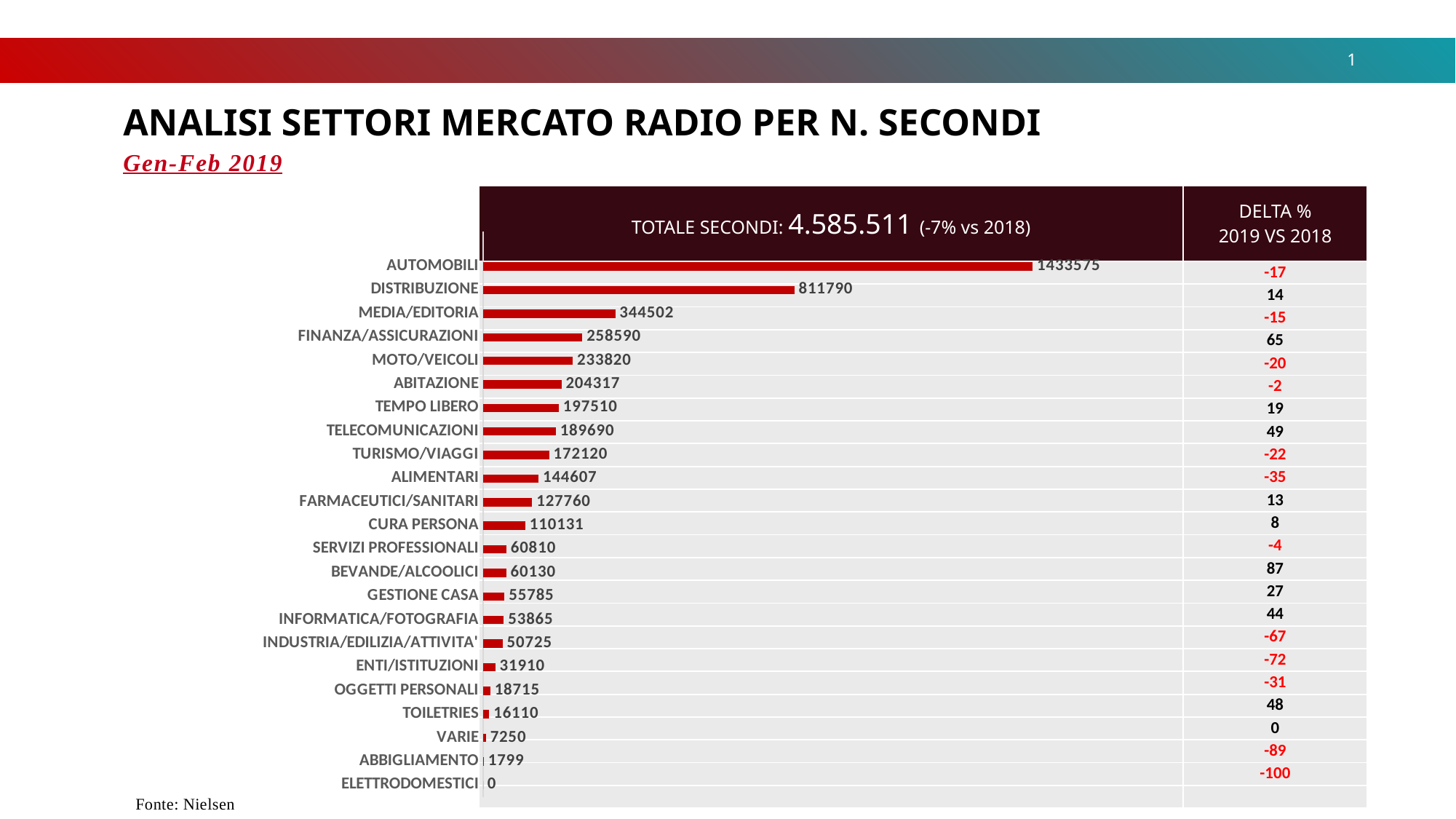
Which is larger, the value for TOILETRIES or the value for VARIE? TOILETRIES What is the value for TELECOMUNICAZIONI? 189690 How many categories are shown in the chart? 23 What is the value for GESTIONE CASA? 55785 Which category has the lowest value? ELETTRODOMESTICI What is the value for AUTOMOBILI? 1433575 What kind of chart is shown on the slide? bar chart Which is larger, the value for MOTO/VEICOLI or the value for ABITAZIONE? MOTO/VEICOLI What total number of seconds is stated in the chart header? 4.585.511 Which category has the highest value? AUTOMOBILI What is the difference between the values for MEDIA/EDITORIA and FINANZA/ASSICURAZIONI? 85912 What is the difference between the values for AUTOMOBILI and DISTRIBUZIONE? 621785